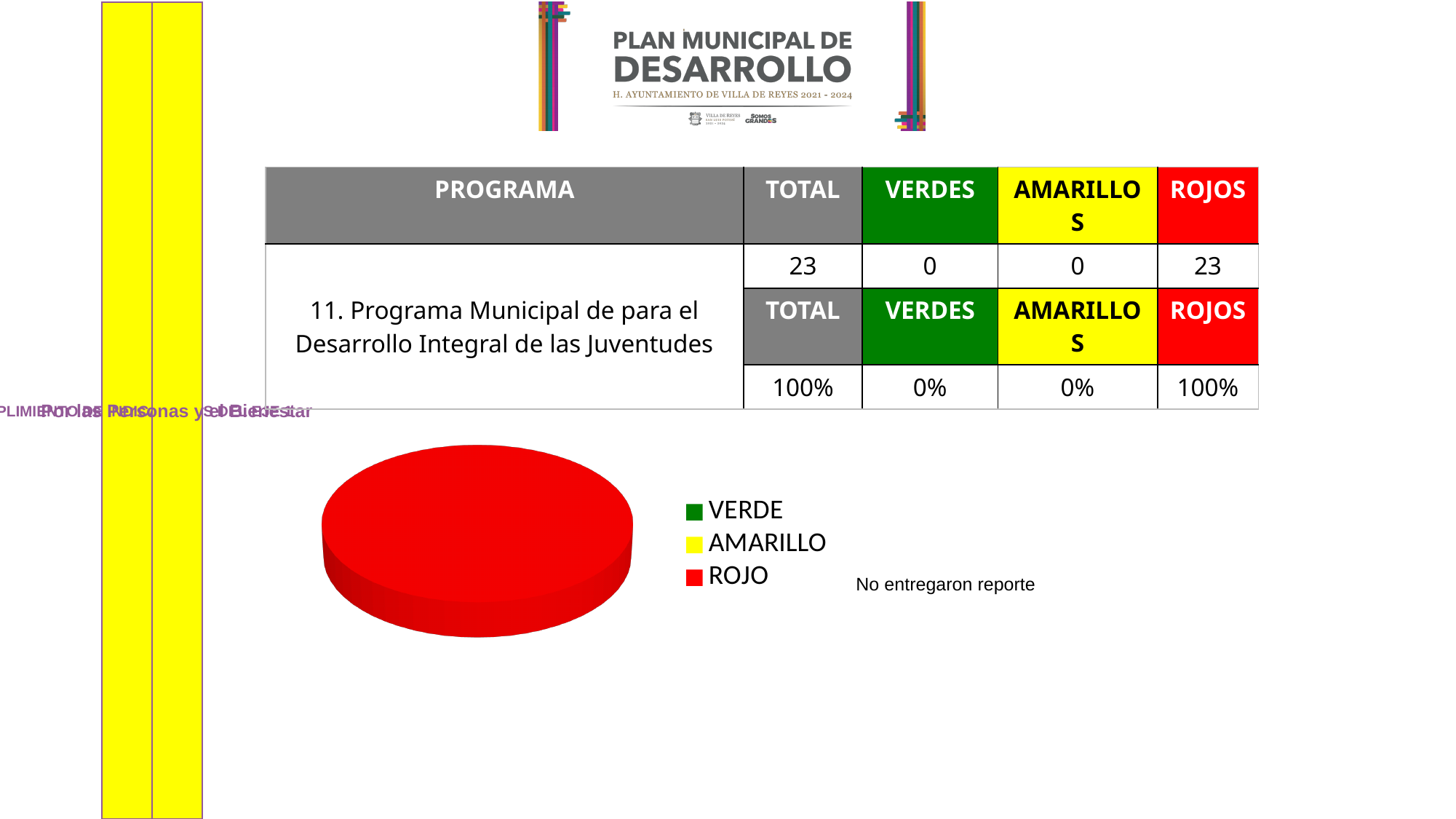
What share of the pie chart does the ROJO slice occupy? 100% Is the share of the VERDE slice in the pie chart larger or smaller than the share of the ROJO slice? smaller Which category takes up the largest share of the pie chart? ROJO Is the share of the AMARILLO slice in the pie chart greater or less than 50%? less Which colour represents ROJO in the pie chart legend? red How many entries does the legend of the pie chart list? 3 What kind of chart is shown on the slide? pie chart Is the share of the ROJO slice in the pie chart greater or less than 50%? greater Which legend entry is shown in green? VERDE